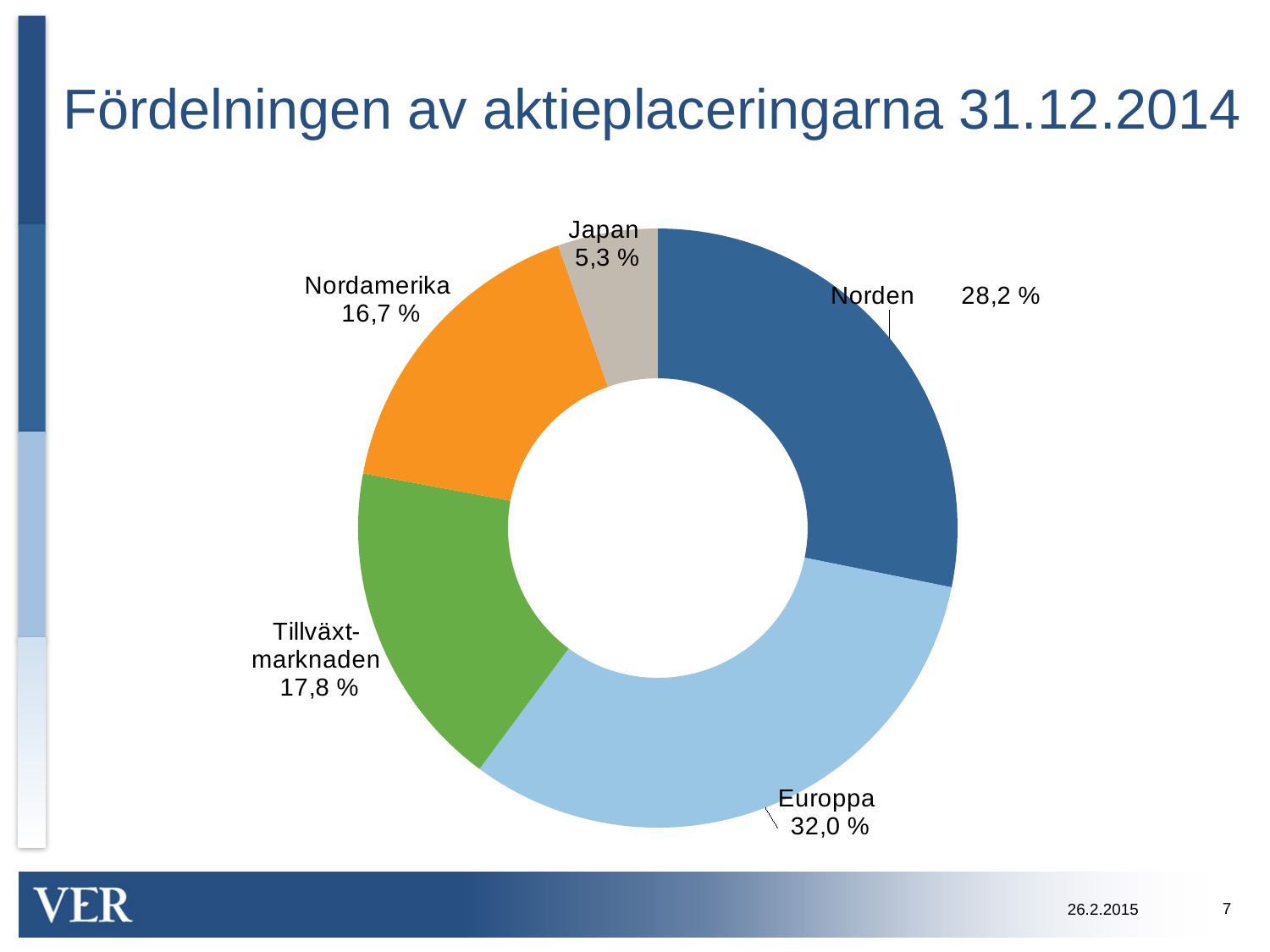
What is the difference in percentage points between the shares of Europa and Norden? 3,8 percentage points What is the title of the chart on the slide? Fördelningen av aktieplaceringarna 31.12.2014 What colour is the Nordamerika segment of the chart? Orange What share of the equity investments is allocated to Europa (Europe)? 32,0 % Which region has the largest share of the equity investments? Europpa Which region has the smallest share of the equity investments? Japan What share of the equity investments is allocated to Tillväxtmarknaden? 17,8 % What share of the equity investments is allocated to Norden? 28,2 % What kind of chart is shown on the slide? Pie (doughnut) chart How many regions are shown in the chart? 5 Which has a larger share, Tillväxtmarknaden or Nordamerika? Tillväxtmarknaden What share of the equity investments is allocated to Japan? 5,3 %